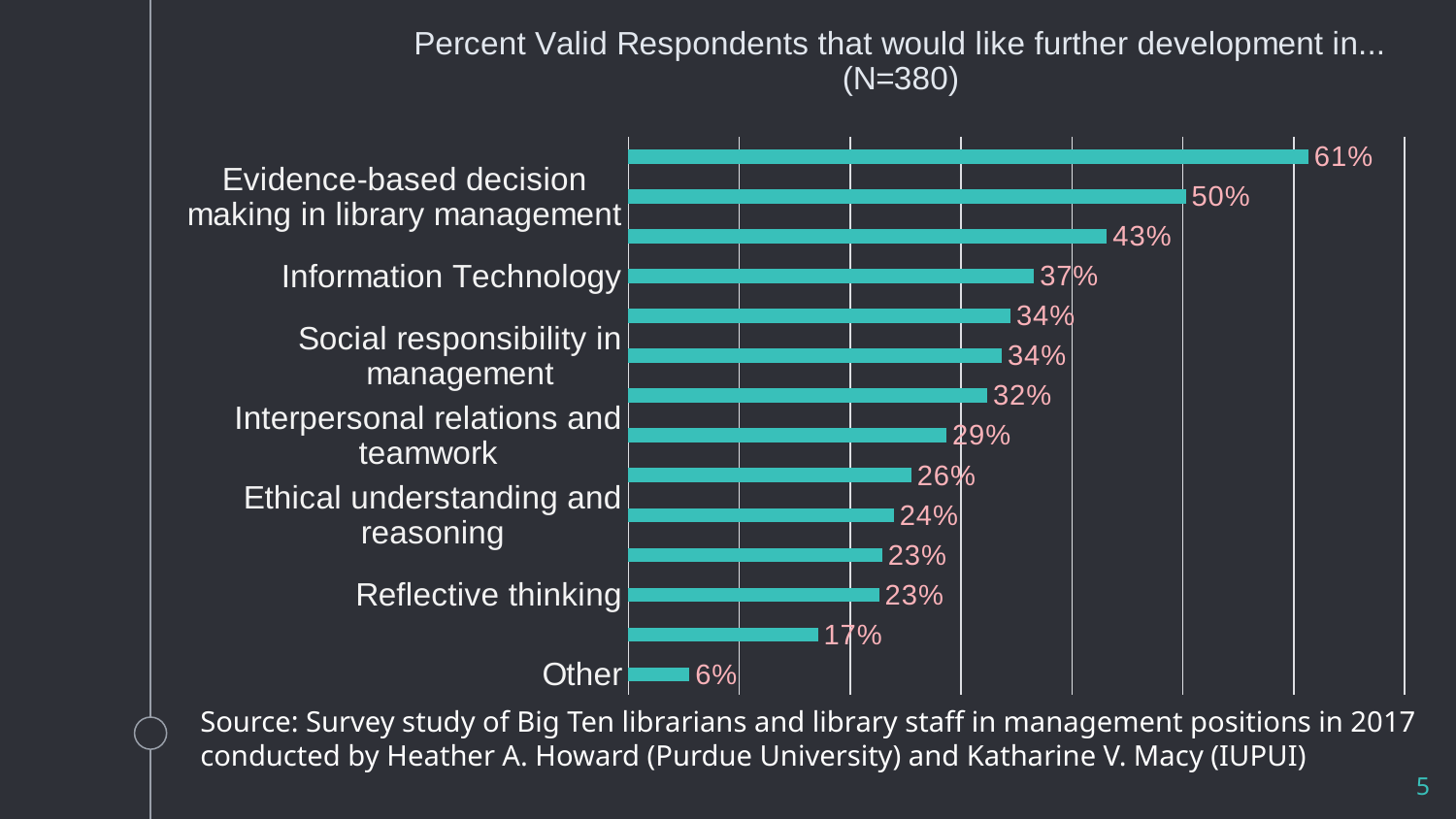
How many bars are plotted on the chart? 14 What is the value for Evidence-based decision making in library management? 50% Which category has the lowest value? Other Which is larger, the value for Ethical understanding and reasoning or the value for Interpersonal relations and teamwork? Interpersonal relations and teamwork What is the highest value shown on the chart? 61% What kind of chart is shown on the slide? bar chart What is the difference between the values for Information Technology and Social responsibility in management? 3 percentage points What is the value for Reflective thinking? 23% What is the value for Other? 6% How many respondents (N) does the chart title state? 380 What is the value for Information Technology? 37% What is the value for Interpersonal relations and teamwork? 29%